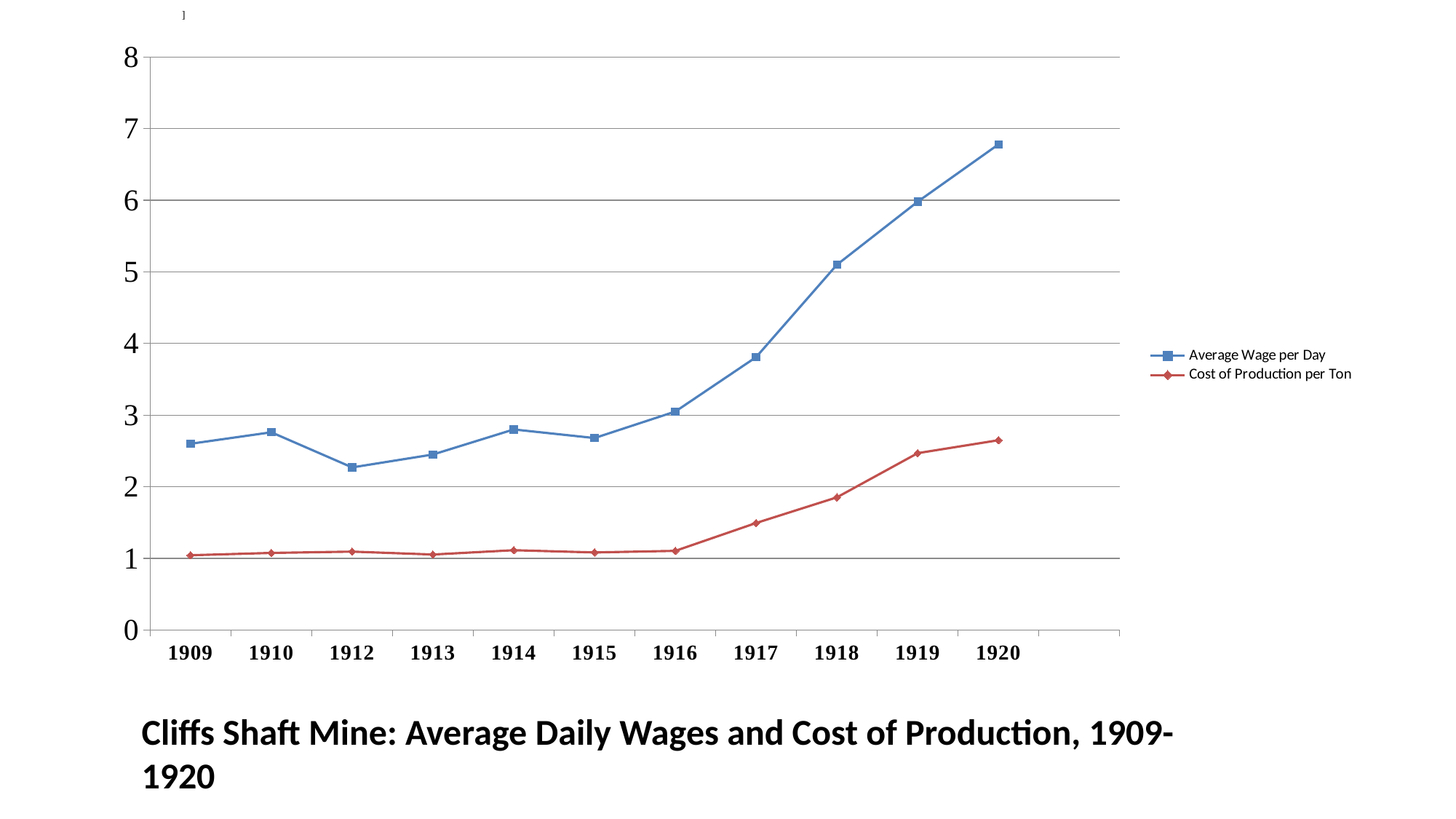
Is the Average Wage per Day in 1917 greater or less than 4? less Does the Average Wage per Day rise or fall from 1916 to 1920? rise In which year is the Cost of Production per Ton highest? 1920 What is the title of the chart? Cliffs Shaft Mine: Average Daily Wages and Cost of Production, 1909-1920 In which year is the Average Wage per Day highest? 1920 In which year is the Average Wage per Day lowest? 1912 How many series does the legend list? 2 How many years are plotted along the x axis? 11 Which is larger, the Average Wage per Day in 1910 or in 1912? 1910 What kind of chart is shown on the slide? line chart Is the Cost of Production per Ton in 1918 greater or less than 2? less Is the Average Wage per Day in 1920 greater or less than 6? greater